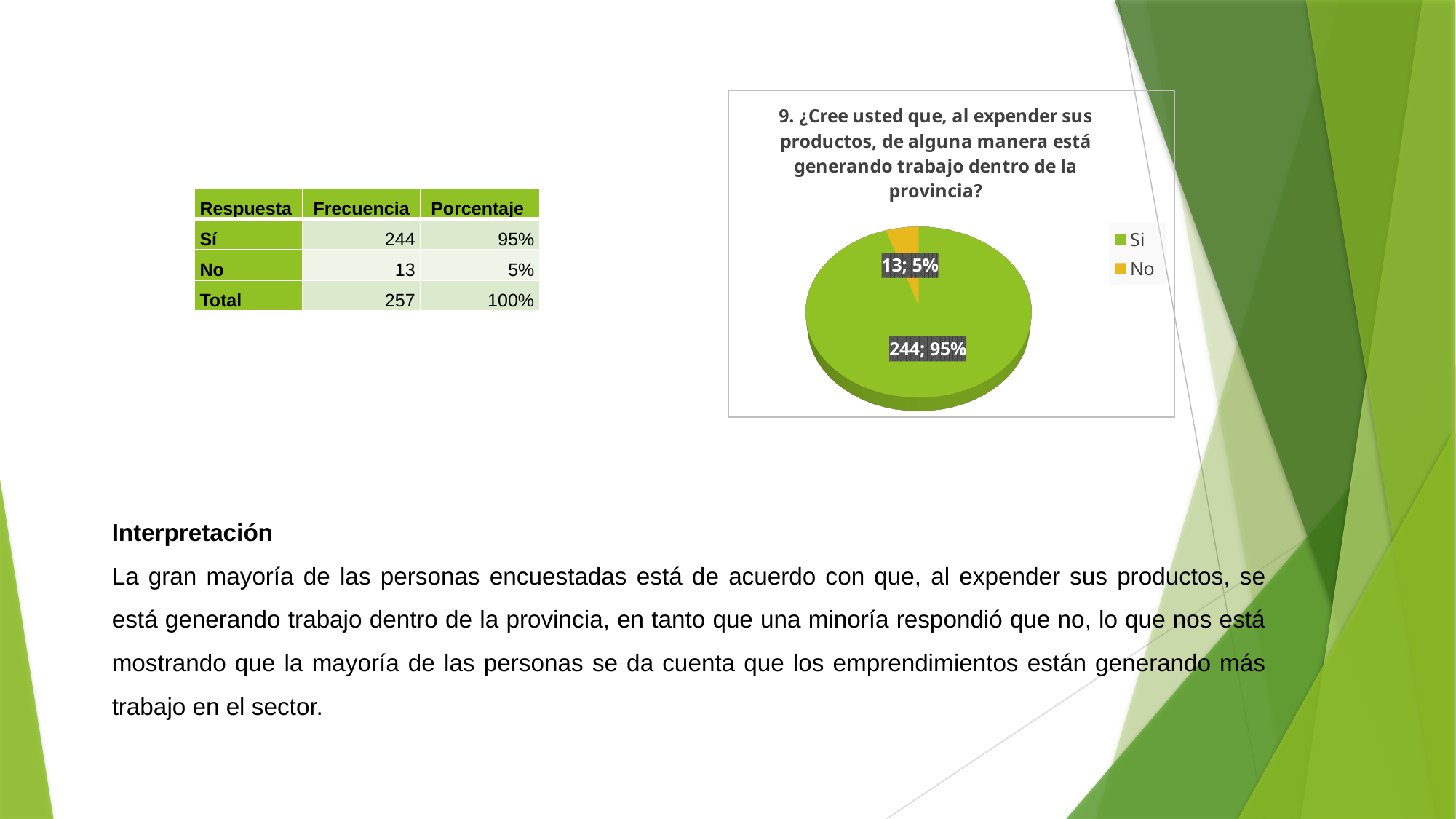
What colour is the No slice in the pie chart? yellow What share of the pie does the Si slice represent? 95% What is the value for No in the pie chart? 13 What kind of chart is shown on the slide? pie chart How many categories does the pie chart show? 2 Which is larger, the value for Si or the value for No? Si What share of the pie does the No slice represent? 5% What is the value for Si in the pie chart? 244 Which category has the smallest slice in the pie chart? No What is the total of the values shown in the pie chart? 257 What is the difference between the values for Si and No? 231 Which category has the largest slice in the pie chart? Si